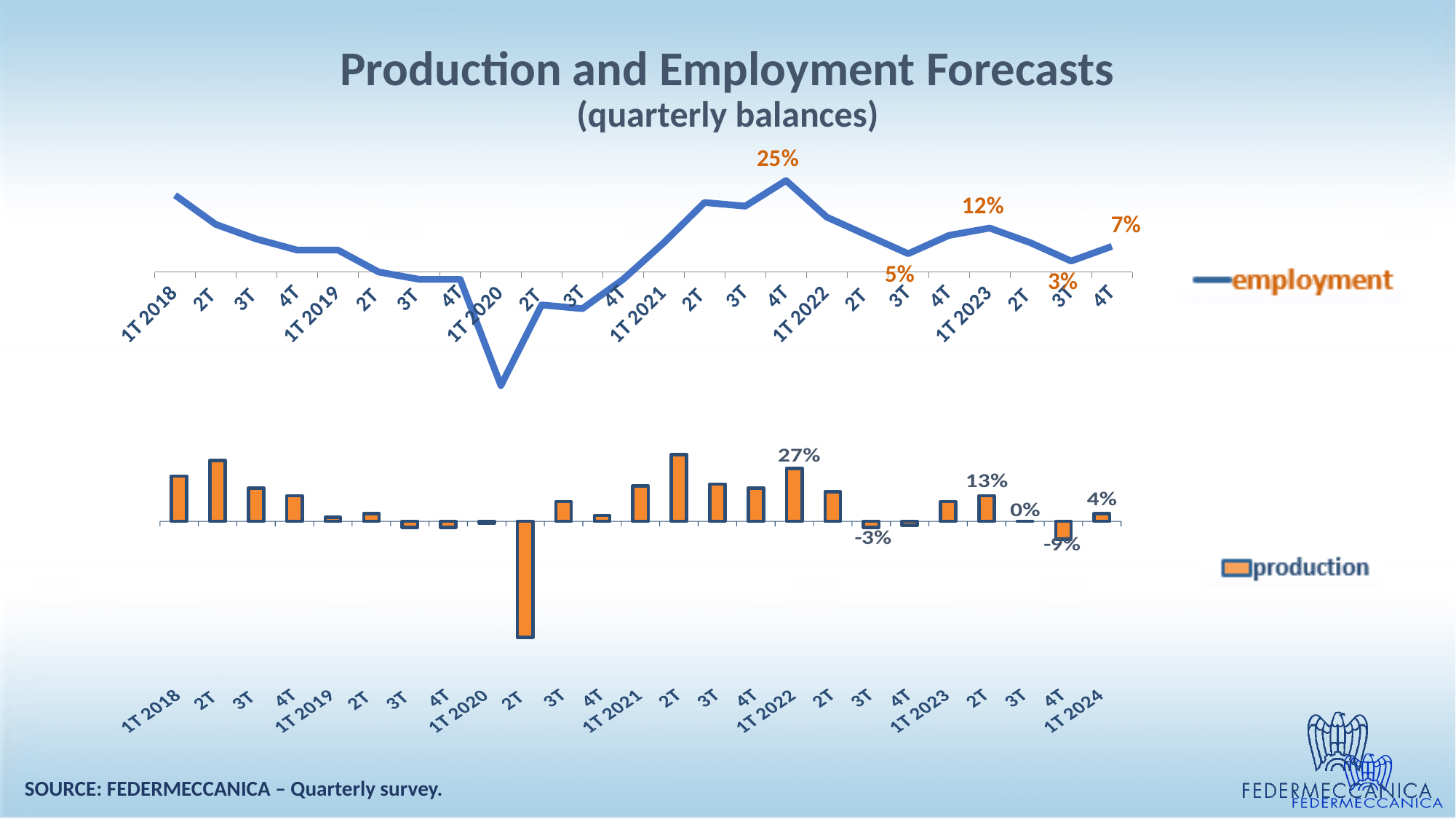
What kind of chart is the bottom production chart? Bar chart In the bottom production bar chart, what is the value for 1T 2022? 27% In the bottom production bar chart, which quarter has the lowest value? 2T 2020 In the top employment line chart, what is the value for 4T 2023? 7% In the top employment line chart, which is larger: the value for 1T 2023 or the value for 3T 2022? 1T 2023 In the top employment line chart, what is the difference between the values for 4T 2021 and 1T 2023? 13 percentage points In the bottom production bar chart, what is the value for 3T 2023? 0% In the top employment line chart, which quarter has the lowest value? 1T 2020 In the bottom production bar chart, what is the difference between the values for 1T 2022 and 2T 2023? 14 percentage points In the bottom production bar chart, what is the value for 4T 2023? -9% In the top employment line chart, what is the value for 4T 2021? 25% In the top employment line chart, what is the value for 3T 2023? 3%